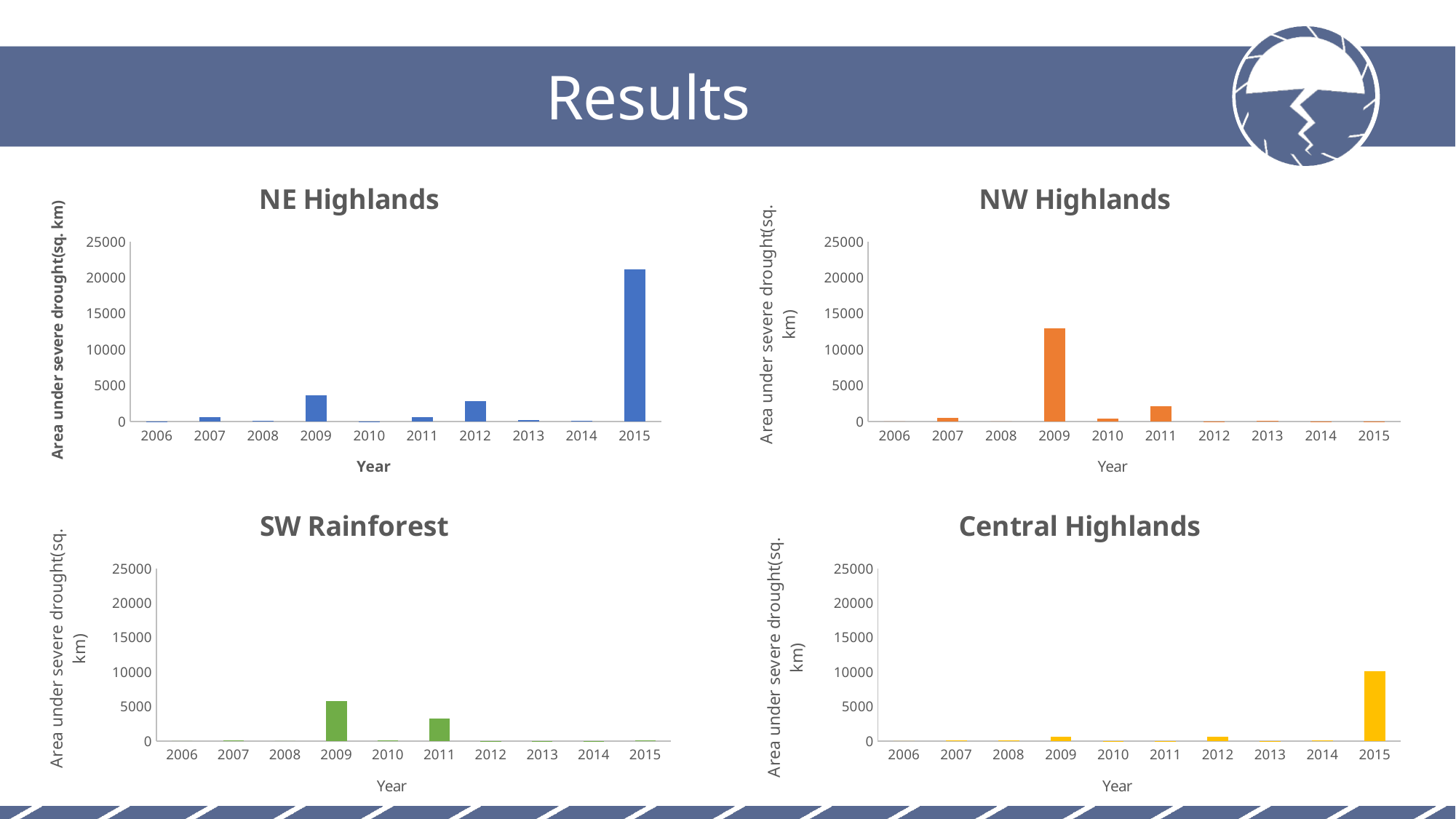
In the SW Rainforest chart, which year has the highest area under severe drought? 2009 In the NE Highlands chart, is the value for 2015 greater or less than 15000? greater In the NE Highlands chart, which is larger, the value for 2009 or the value for 2012? 2009 In the NE Highlands chart, which year has the highest area under severe drought? 2015 In the NW Highlands chart, which year has the highest area under severe drought? 2009 In the NW Highlands chart, is the value for 2009 greater or less than 10000? greater In the SW Rainforest chart, is the value for 2011 greater or less than 5000? less How many years are shown on the x axis of the Central Highlands chart? 10 What kind of chart is the SW Rainforest chart? bar chart